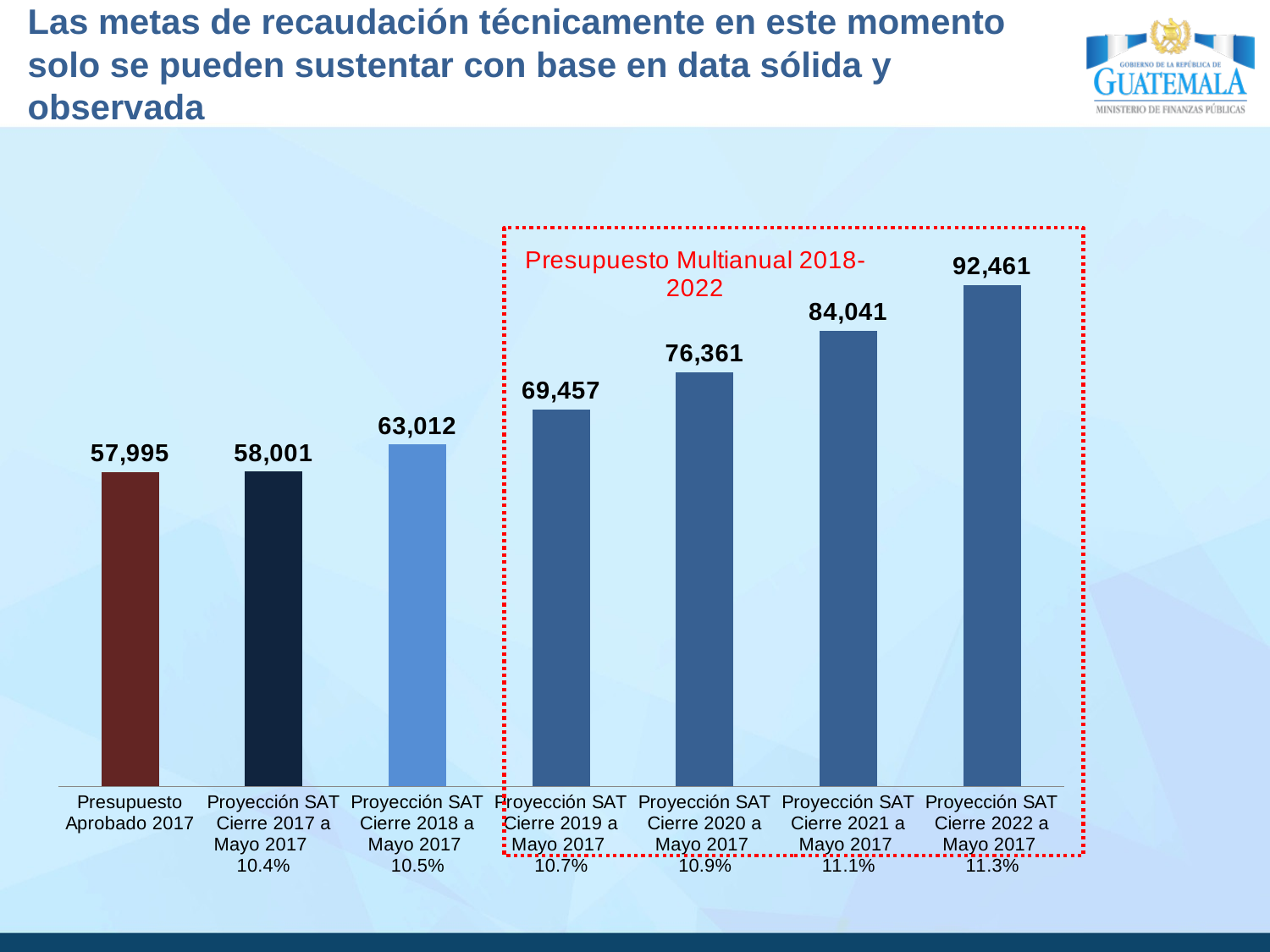
What is the value for Presupuesto Aprobado 2017? 57,995 Which is larger, the value for Proyección SAT Cierre 2020 a Mayo 2017 or Proyección SAT Cierre 2021 a Mayo 2017? Proyección SAT Cierre 2021 a Mayo 2017 What is the difference between the values for Proyección SAT Cierre 2022 a Mayo 2017 and Proyección SAT Cierre 2021 a Mayo 2017? 8,420 What is the difference between the values for Proyección SAT Cierre 2019 a Mayo 2017 and Proyección SAT Cierre 2018 a Mayo 2017? 6,445 Which category has the lowest value? Presupuesto Aprobado 2017 What is the value for Proyección SAT Cierre 2018 a Mayo 2017? 63,012 Do the values rise or fall from left to right across the categories? Rise What is the value for Proyección SAT Cierre 2020 a Mayo 2017? 76,361 How many bars are shown in the chart? 7 What kind of chart is shown on the slide? Bar chart Which category has the highest value? Proyección SAT Cierre 2022 a Mayo 2017 What label appears inside the red dotted box on the chart? Presupuesto Multianual 2018-2022